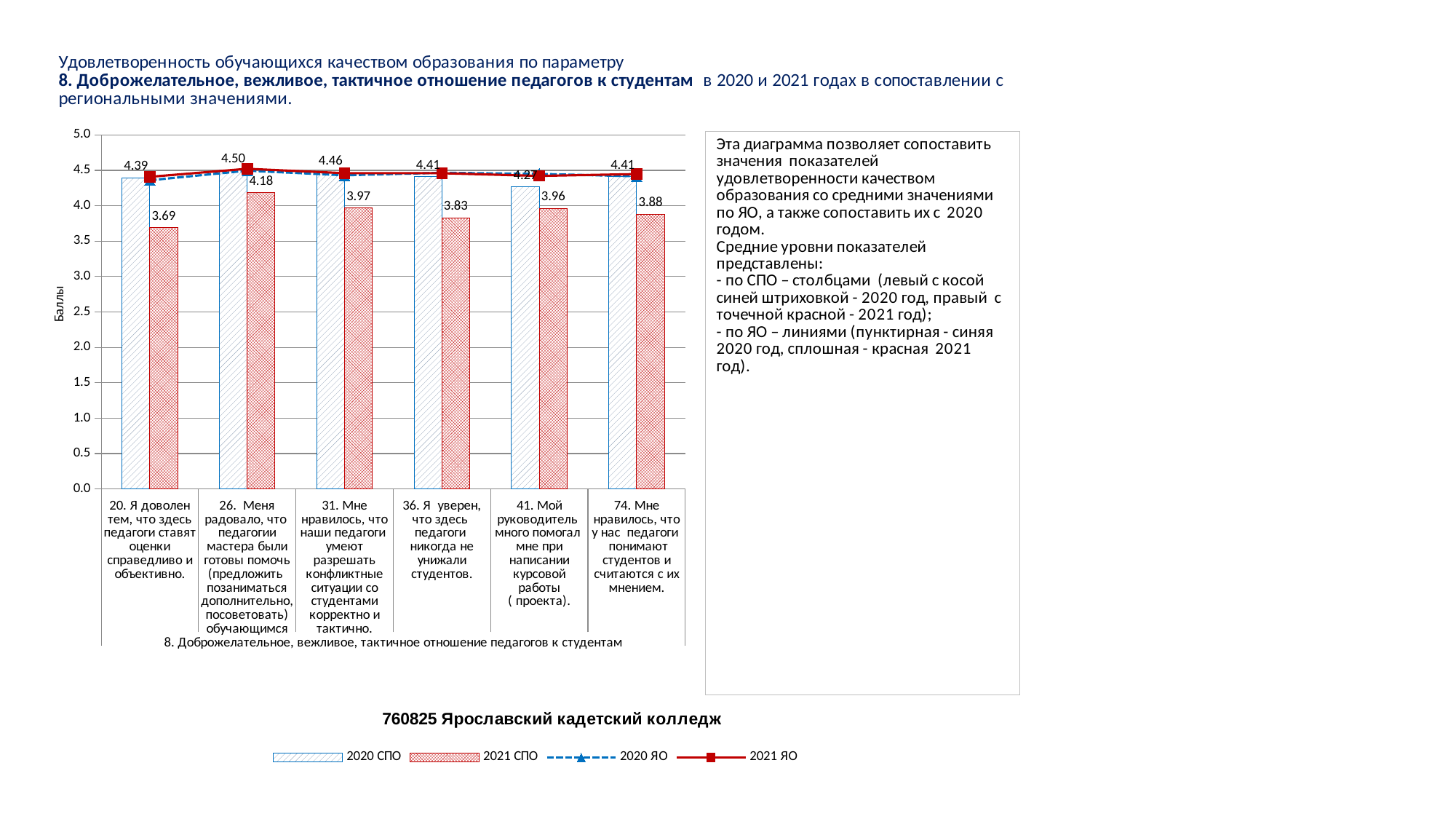
Is the 2021 СПО value for question 31 greater or less than 4.0? less What is the difference between the 2020 СПО and 2021 СПО values for question 20? 0.70 What is the label of the vertical axis? Баллы What is the 2021 СПО value for question 26 ("Меня радовало, что педагогии мастера были готовы помочь...")? 4.18 What is the 2021 СПО value for question 74 ("Мне нравилось, что у нас педагоги понимают студентов и считаются с их мнением")? 3.88 Which question has the highest 2020 СПО value? 26. Меня радовало, что педагогии мастера были готовы помочь How many questions (categories) are shown on the x axis? 6 How many series does the legend list? 4 For question 41 ("Мой руководитель много помогал мне при написании курсовой работы"), which is larger: the 2020 СПО value or the 2021 СПО value? 2020 СПО What kind of chart is shown on the slide? Combined bar and line chart Which question has the lowest 2021 СПО value? 20. Я доволен тем, что здесь педагоги ставят оценки справедливо и объективно What is the 2020 СПО value for question 20 ("Я доволен тем, что здесь педагоги ставят оценки справедливо и объективно")? 4.39